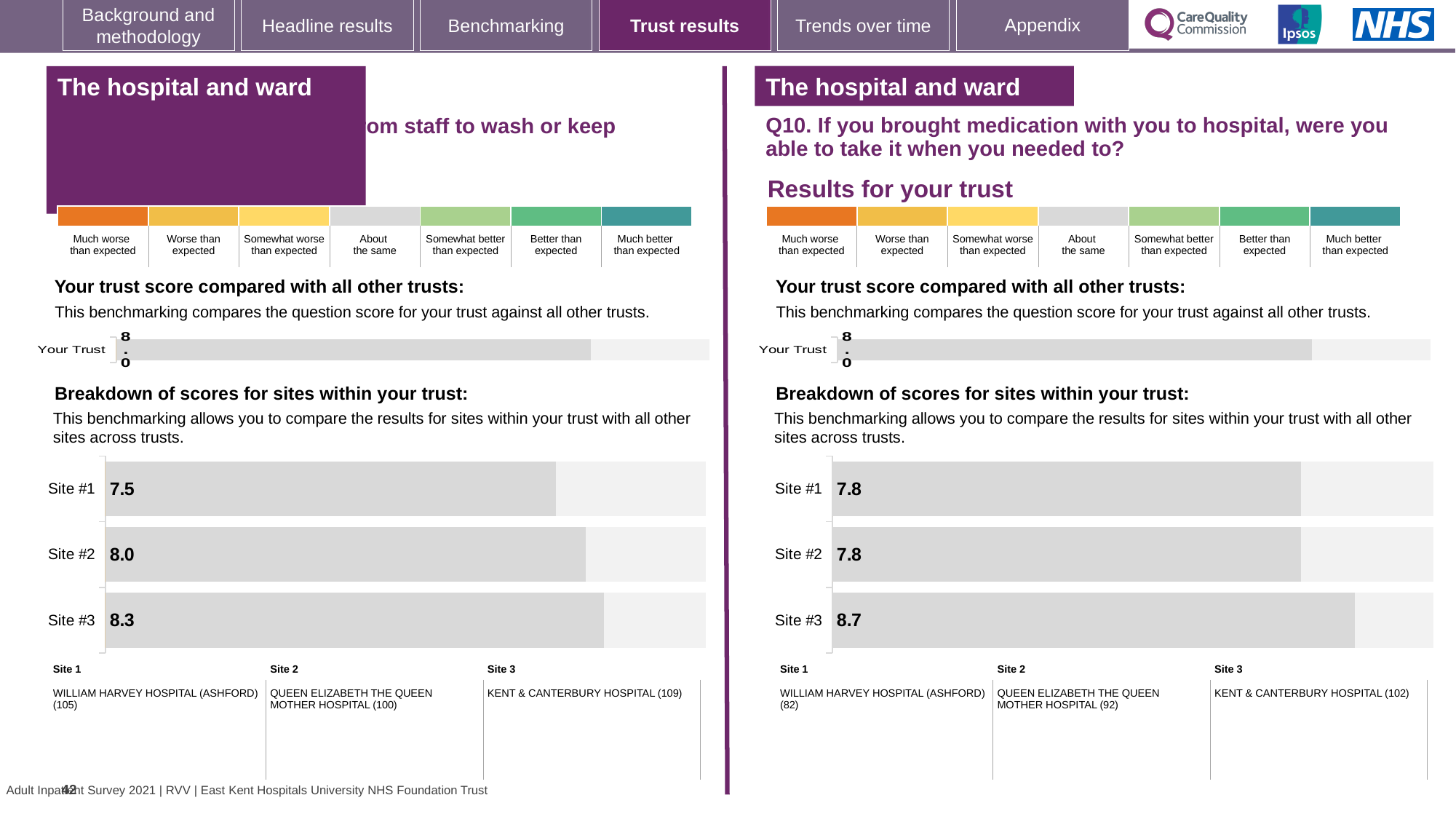
In the left-hand site breakdown chart, is the score for Site #2 larger than the score for Site #1? Yes, Site #2 (8.0) is larger How many sites are shown in the right-hand site breakdown chart (Q10)? 3 In the right-hand site breakdown chart (Q10), what is the difference between the scores for Site #3 and Site #2? 0.9 What is the trust score shown in the 'Your Trust' chart on the right-hand side (Q10)? 8.0 In the right-hand site breakdown chart (Q10), what is the score for Site #3? 8.7 In the left-hand site breakdown chart, what is the score for Site #1? 7.5 In the left-hand site breakdown chart, which site has the lowest score? Site #1 In the left-hand site breakdown chart, what is the difference between the scores for Site #3 and Site #1? 0.8 In the right-hand site breakdown chart (Q10), which site has the highest score? Site #3 What type of chart is used for the site breakdown on the left-hand side of the slide? Bar chart In the right-hand site breakdown chart (Q10), is the score for Site #1 larger than, smaller than, or equal to the score for Site #2? equal In the left-hand site breakdown chart, which site has the highest score? Site #3